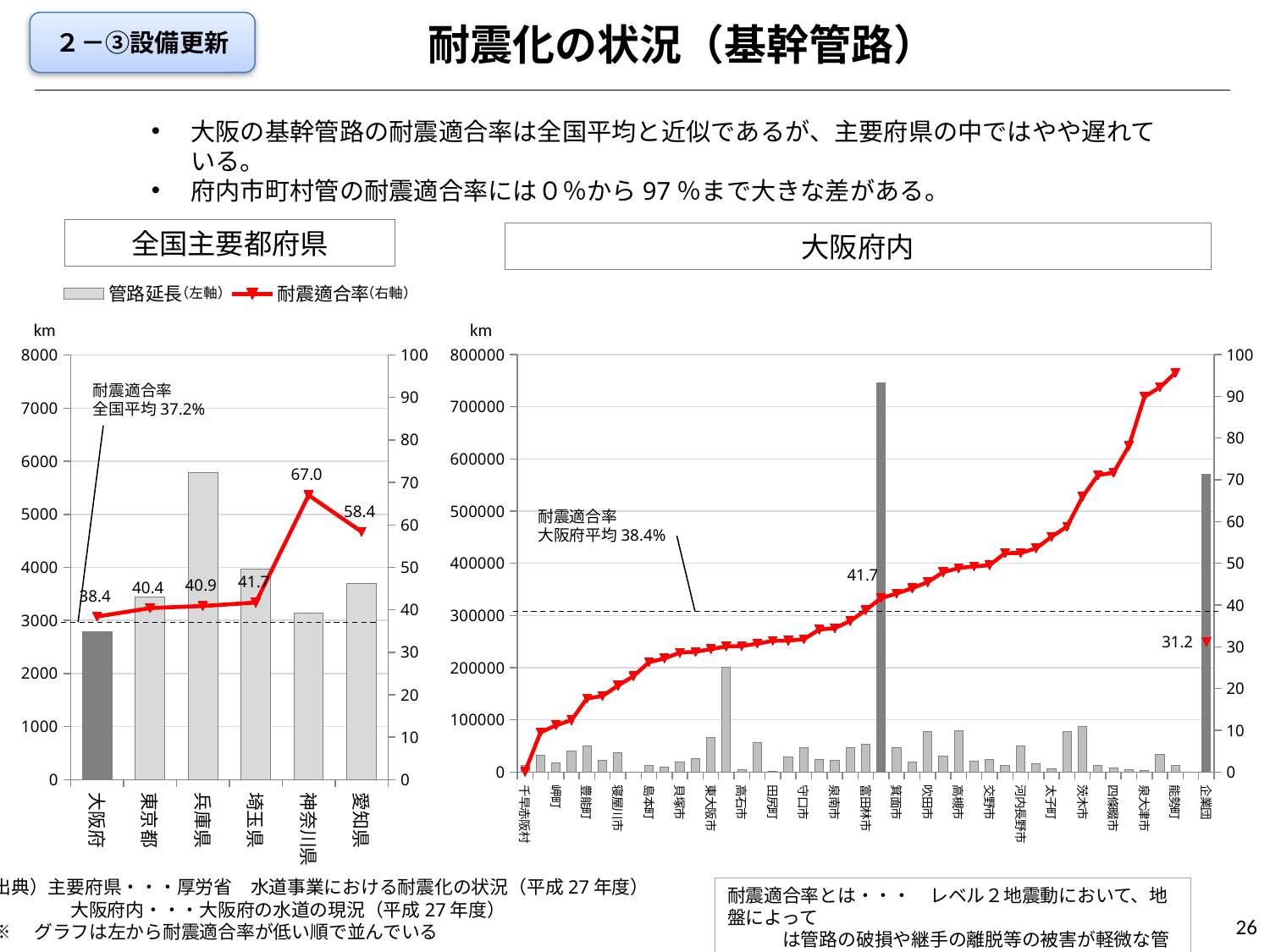
In the 全国主要都府県 chart on the left, which prefecture has the longest 管路延長 bar? 兵庫県 In the 大阪府内 chart on the right, what is the 耐震適合率 for 企業団? 31.2 In the 全国主要都府県 chart on the left, what is the difference in 耐震適合率 between 神奈川県 and 愛知県? 8.6 What is the 全国平均 耐震適合率 noted on the 全国主要都府県 chart on the left? 37.2% In the 大阪府内 chart on the right, does the 耐震適合率 line rise or fall from left to right? rise In the 全国主要都府県 chart on the left, what is the 耐震適合率 for 大阪府? 38.4 How many prefectures are shown in the 全国主要都府県 chart on the left? 6 In the 全国主要都府県 chart on the left, which prefecture has the lowest 耐震適合率? 大阪府 In the 全国主要都府県 chart on the left, what is the 耐震適合率 for 神奈川県? 67.0 In the 全国主要都府県 chart on the left, is the 管路延長 value for 兵庫県 greater or less than 5000 km? greater In the 全国主要都府県 chart on the left, which prefecture has the highest 耐震適合率? 神奈川県 In the 大阪府内 chart on the right, is the 管路延長 value for 富田林市 greater or less than 700000 km? less